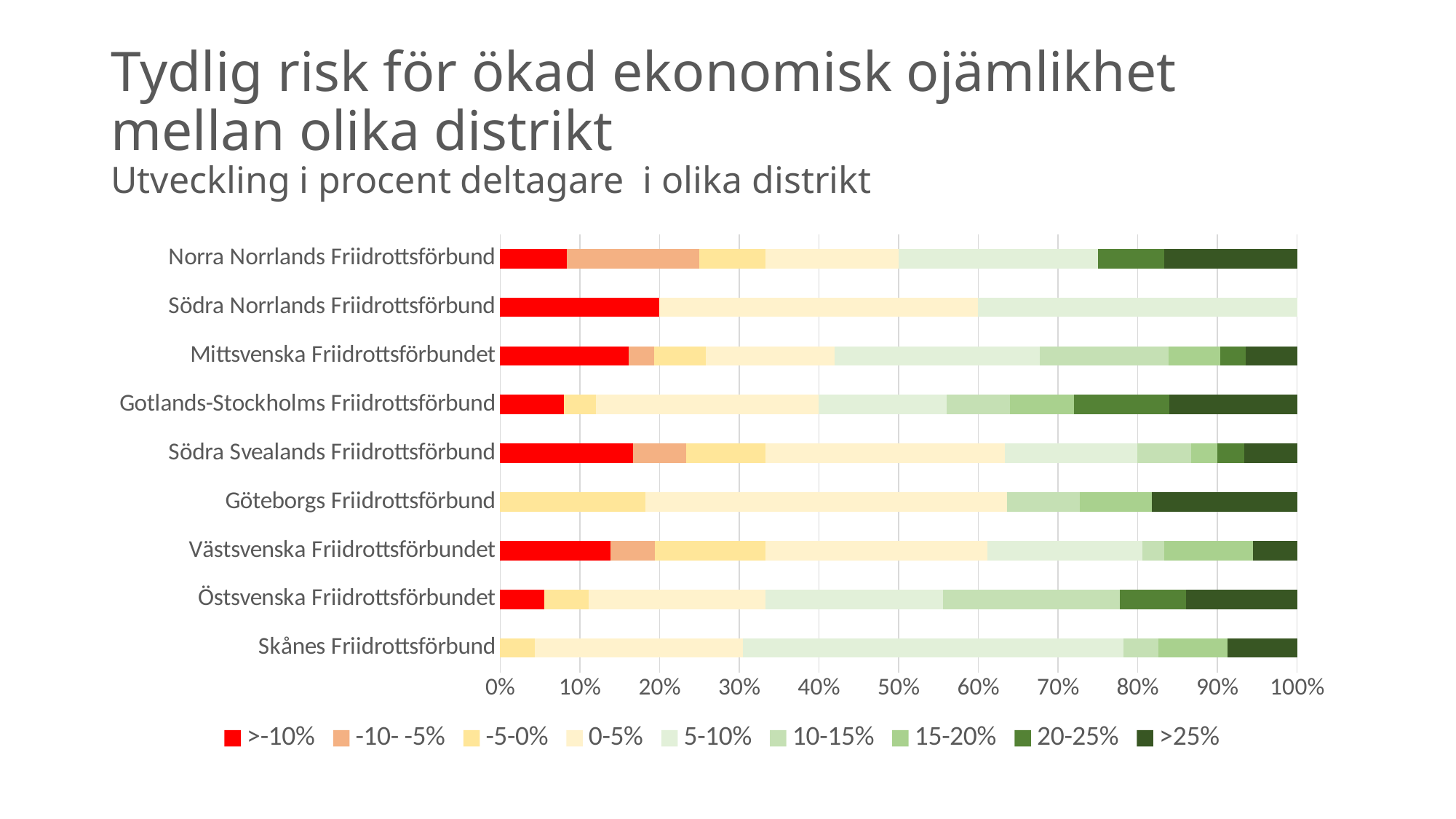
What does each stacked bar total on the x axis? 100% What kind of chart is shown on the slide? stacked bar chart Is the '>-10%' share for Mittsvenska Friidrottsförbundet greater or less than 10%? greater What is the first entry in the chart legend? >-10% Which has the larger '>-10%' share, Södra Norrlands Friidrottsförbund or Norra Norrlands Friidrottsförbund? Södra Norrlands Friidrottsförbund How many districts (categories) are shown on the chart? 9 How many series does the legend list? 9 Is the '>-10%' share for Östsvenska Friidrottsförbundet greater or less than 10%? less Is the '0-5%' share for Södra Norrlands Friidrottsförbund greater or less than 30%? greater Which district has the largest '>-10%' share? Södra Norrlands Friidrottsförbund What is the subtitle describing the chart? Utveckling i procent deltagare i olika distrikt